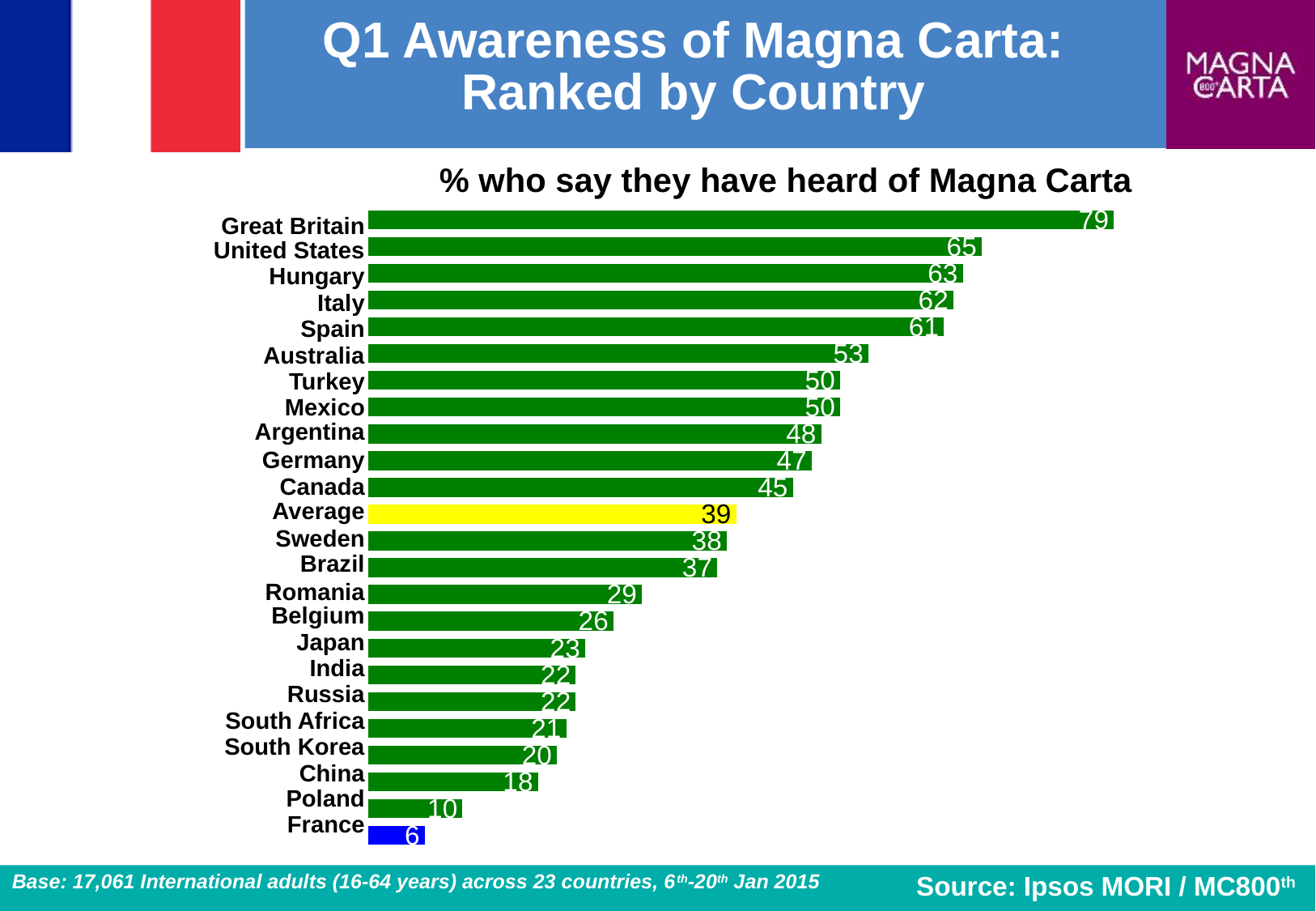
Which country has the lowest value? France Which has a larger value, Poland or China? China How many bars are plotted in the chart, including the Average bar? 24 Which country has the highest value? Great Britain What is the difference between the values for Canada and Sweden? 7 Which bar is coloured yellow? Average What is the difference between the values for Great Britain and the United States? 14 What is the value for Great Britain? 79 What is the value for Germany? 47 What kind of chart is shown on the slide? Bar chart What is the value shown for the Average bar? 39 Which has a larger value, Australia or Brazil? Australia